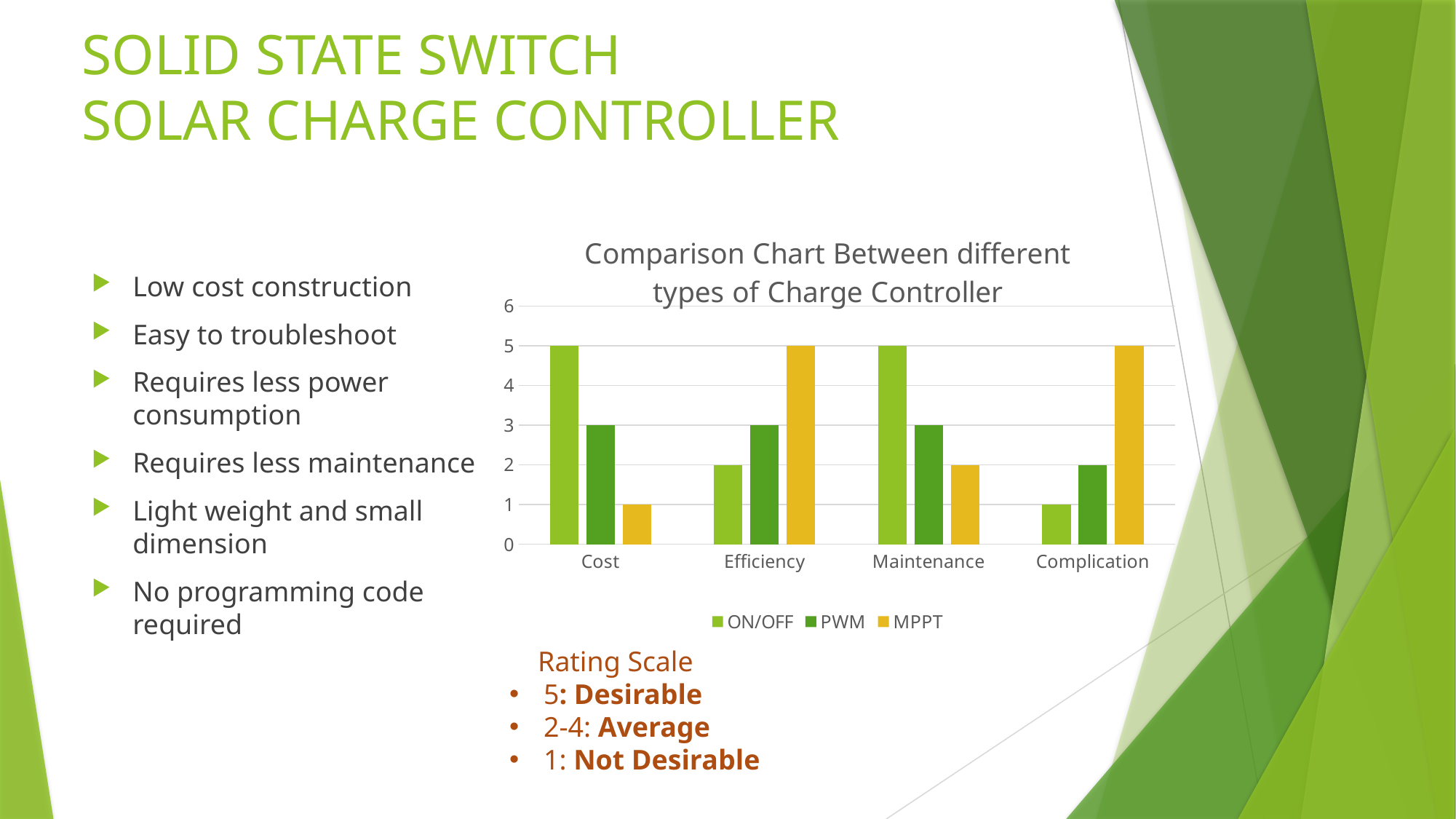
How many series does the chart legend list? 3 What is the difference between the ON/OFF and MPPT values in the Cost category? 4 What is the value for MPPT in the Maintenance category? 2 What is the value for MPPT in the Efficiency category? 5 Which series has the lowest value in the Cost category? MPPT What is the value for PWM in the Complication category? 2 Which is larger in the Efficiency category, the ON/OFF value or the PWM value? PWM What is the title of the chart? Comparison Chart Between different types of Charge Controller How many categories are shown on the x axis of the chart? 4 Which series has the highest value in the Complication category? MPPT What type of chart is shown on the slide? bar chart What is the value for ON/OFF in the Cost category? 5